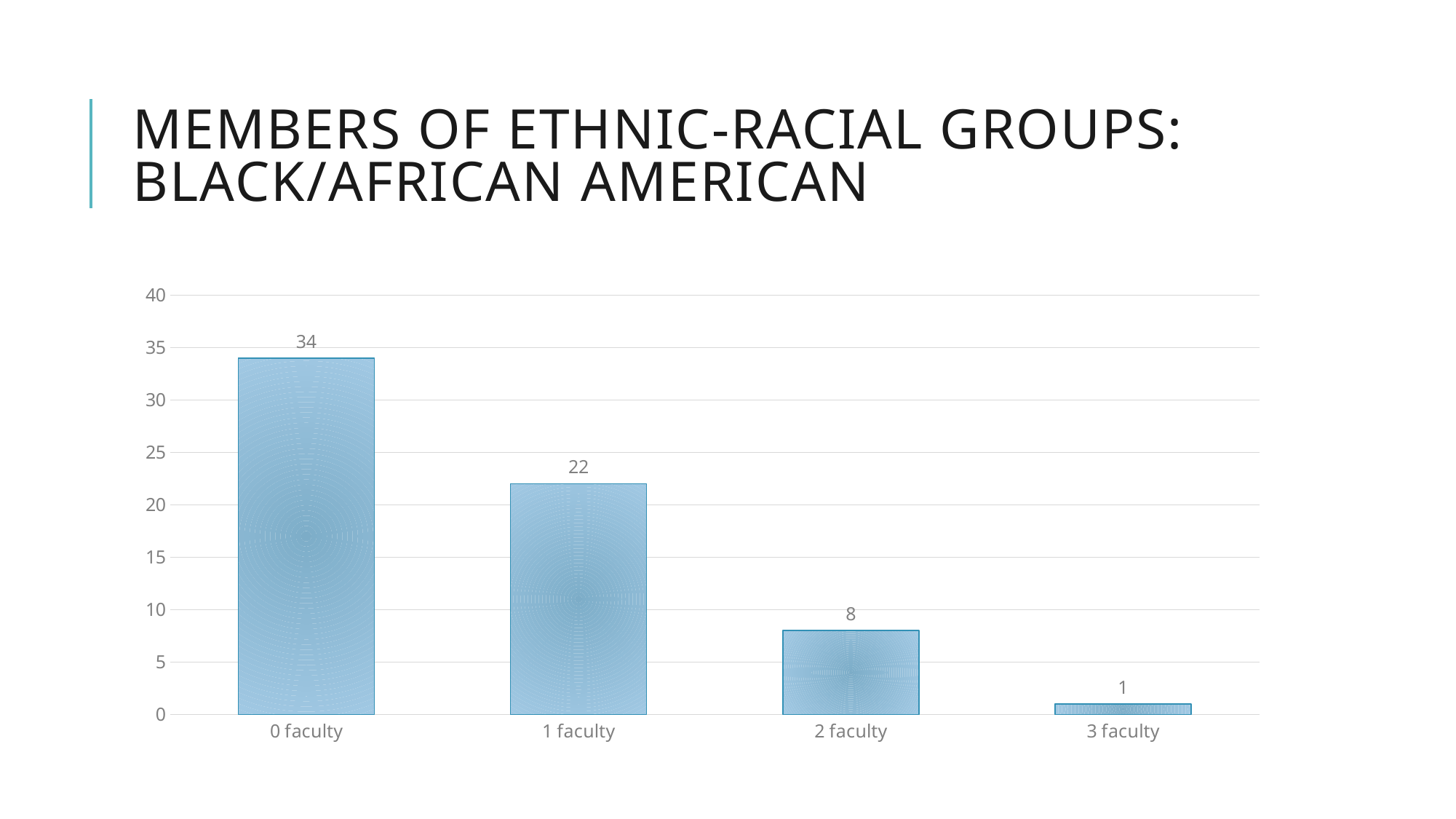
Which category has the highest value? 0 faculty What is the difference between the values for 0 faculty and 1 faculty? 12 Which is larger, the value for 1 faculty or the value for 2 faculty? 1 faculty What is the value for 1 faculty? 22 Which category has the lowest value? 3 faculty What kind of chart is shown on the slide? bar chart What is the value for 3 faculty? 1 How many categories are shown on the x axis? 4 Do the values rise or fall from 0 faculty to 3 faculty? fall What is the value for 0 faculty? 34 What is the value for 2 faculty? 8 What is the difference between the values for 2 faculty and 3 faculty? 7